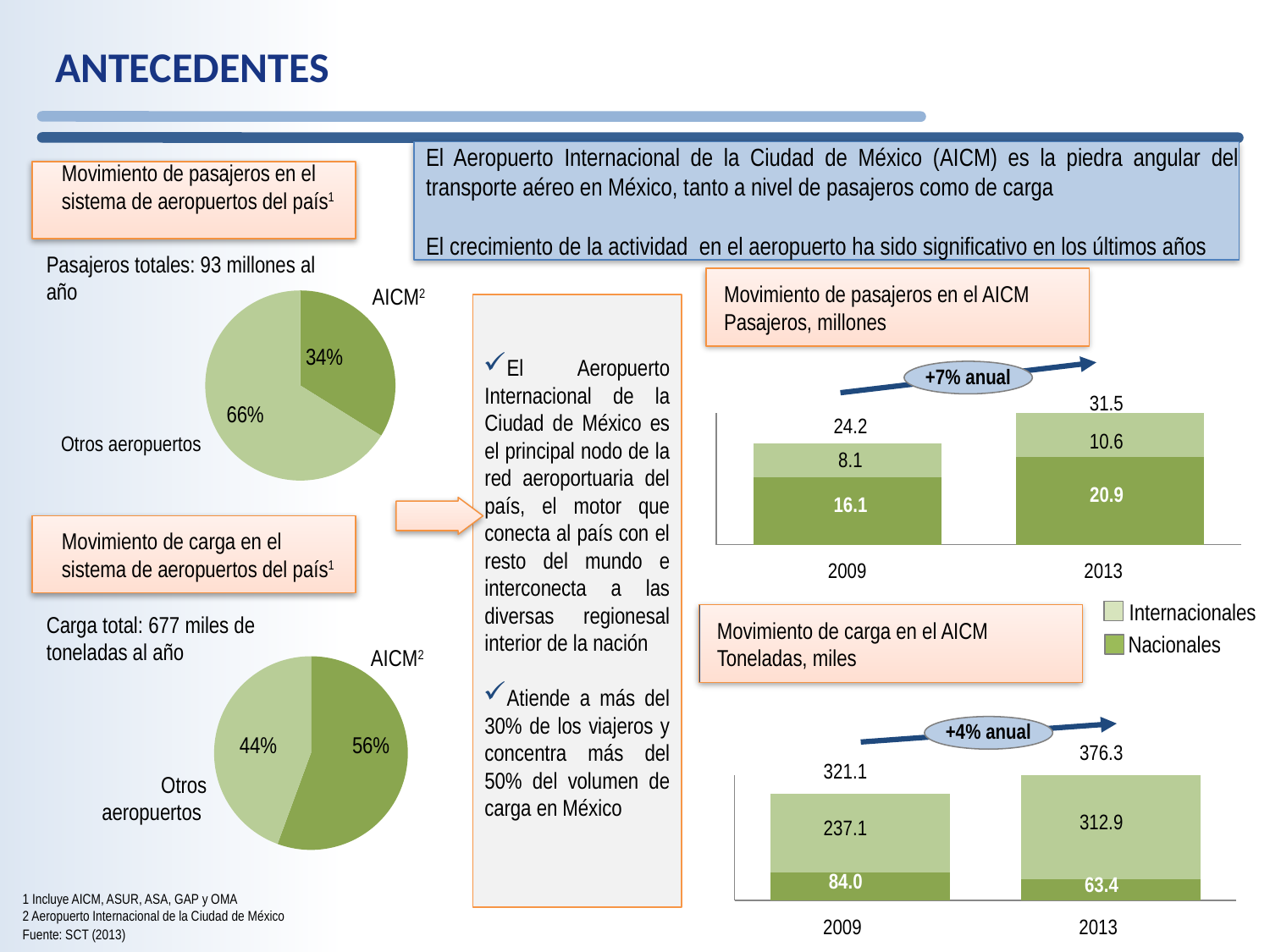
In the 'Movimiento de carga en el sistema de aeropuertos del país' pie chart, which slice is larger, AICM or Otros aeropuertos? AICM How many series does the legend list for the 'Movimiento de pasajeros en el AICM' chart? 2 In the 'Movimiento de pasajeros en el AICM' chart, what is the value for Nacionales in 2013? 20.9 In the 'Movimiento de carga en el AICM' chart, what is the value for Nacionales in 2009? 84.0 In the 'Movimiento de pasajeros en el sistema de aeropuertos del país' pie chart, what share does AICM have? 34% In the 'Movimiento de pasajeros en el AICM' chart, what is the difference between the Internacionales values for 2013 and 2009? 2.5 What kind of chart is 'Movimiento de carga en el AICM'? stacked bar chart In the 'Movimiento de pasajeros en el AICM' chart, what is the total of the stacked bar for 2009? 24.2 In the 'Movimiento de carga en el sistema de aeropuertos del país' pie chart, what share do 'Otros aeropuertos' have? 44% In the 'Movimiento de carga en el AICM' chart, do the Nacionales values rise or fall from 2009 to 2013? fall In the 'Movimiento de carga en el AICM' chart, what is the total of the stacked bar for 2013? 376.3 In the 'Movimiento de carga en el AICM' chart, what is the value for Internacionales in 2013? 312.9